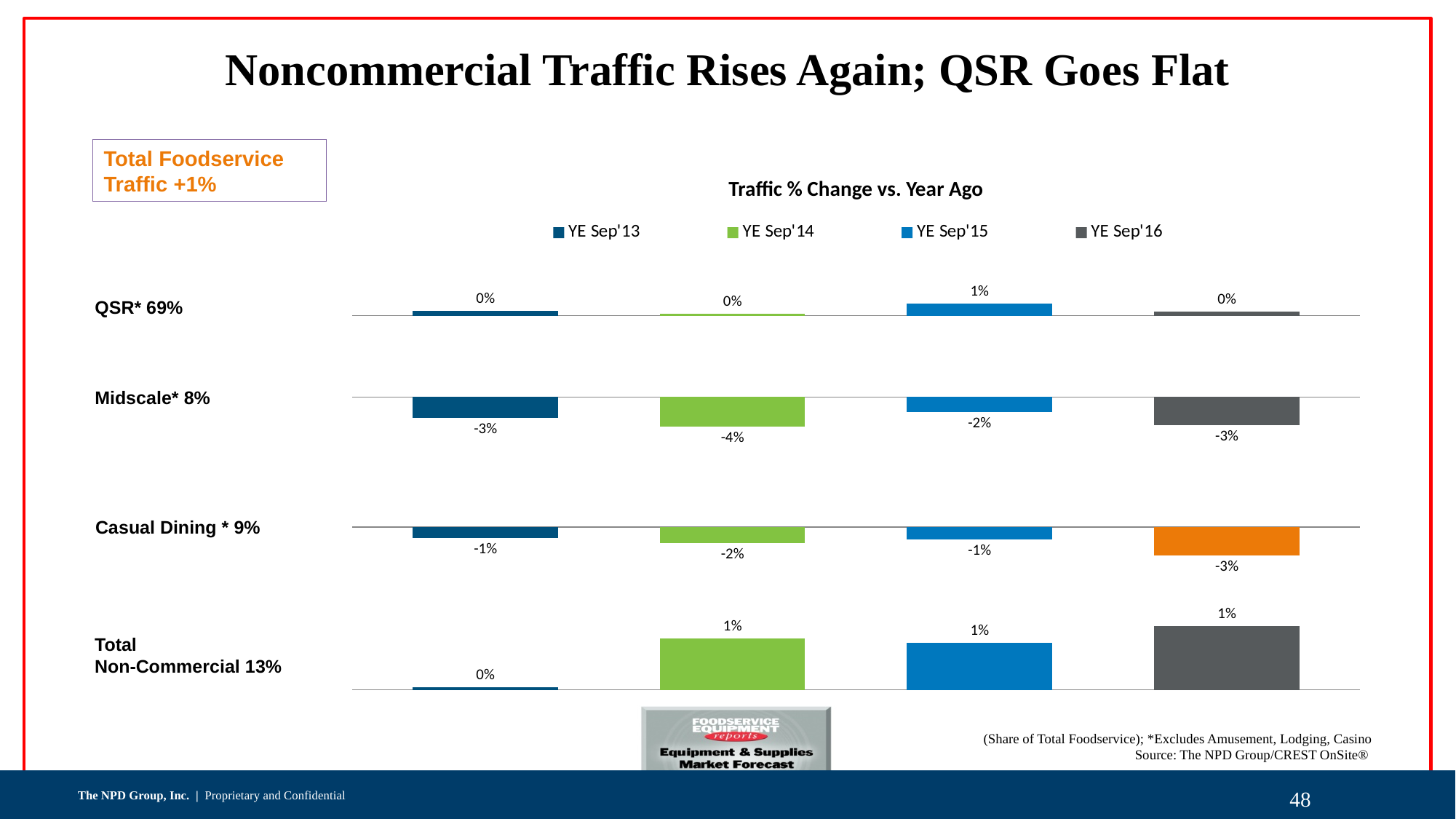
Which year has the lowest traffic % change for Midscale? YE Sep'14 What is the difference between the Midscale traffic % change in YE Sep'14 and YE Sep'15? 2 percentage points What is the traffic % change for QSR in YE Sep'15? 1% How many categories (segments) are shown on the chart? 4 What is the traffic % change for Total Non-Commercial in YE Sep'13? 0% Which is larger, the Casual Dining traffic % change in YE Sep'13 or in YE Sep'16? YE Sep'13 What is the title of the chart? Traffic % Change vs. Year Ago What is the traffic % change for Casual Dining in YE Sep'16? -3% How many series does the chart legend list? 4 Which year has the lowest traffic % change for Casual Dining? YE Sep'16 What kind of chart is shown on the slide? Bar chart What is the traffic % change for Midscale in YE Sep'14? -4%